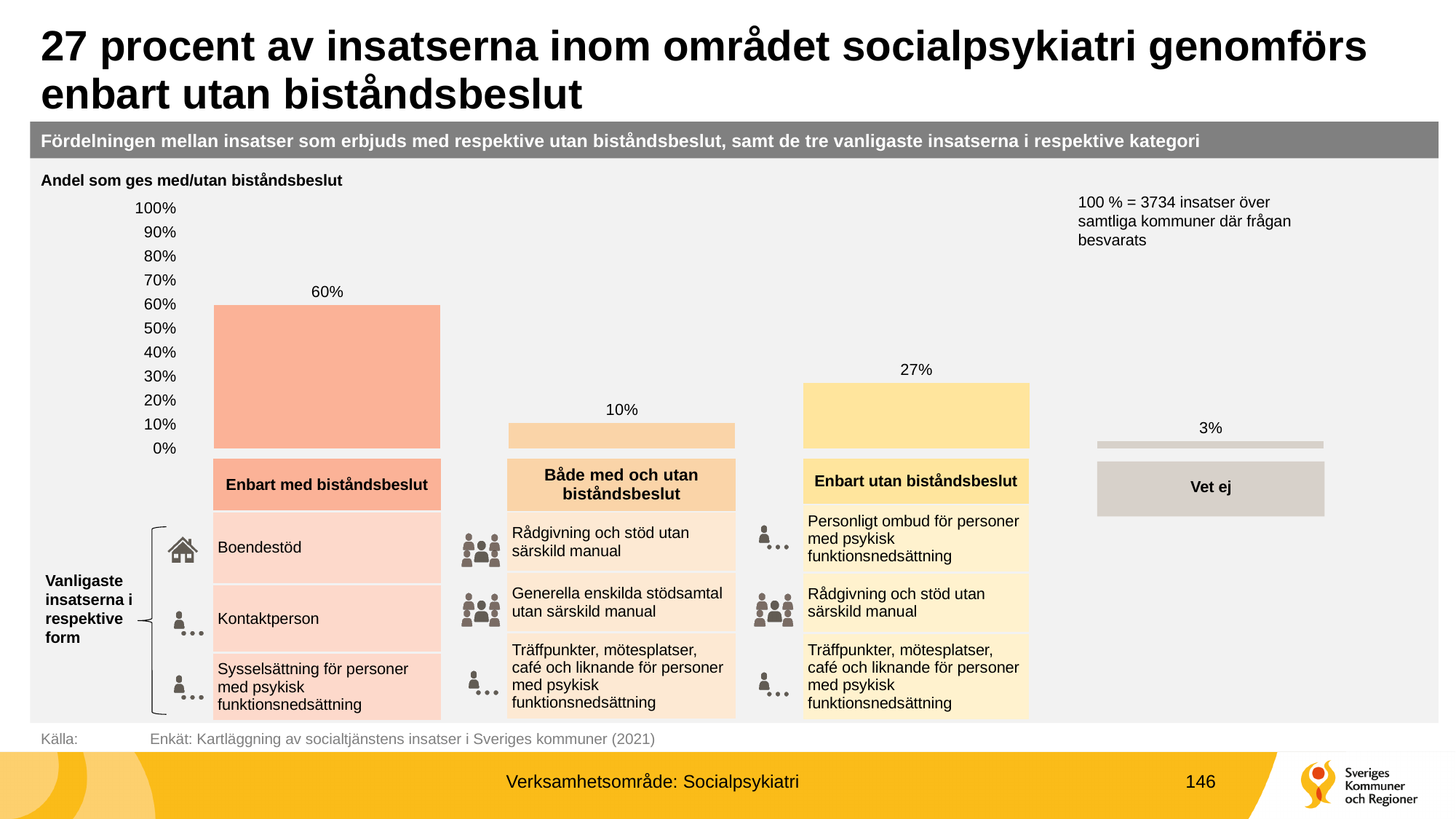
How many categories are shown in the bar chart? 4 Which category has the lowest share? Vet ej What is the title of the chart area above the bars? Andel som ges med/utan biståndsbeslut What is the difference in percentage points between 'Enbart med biståndsbeslut' and 'Enbart utan biståndsbeslut'? 33 percentage points How many insatser does 100% correspond to according to the note on the chart? 3734 Which is larger, the share for 'Både med och utan biståndsbeslut' or the share for 'Enbart utan biståndsbeslut'? Enbart utan biståndsbeslut What percentage of insatser is shown for 'Enbart med biståndsbeslut'? 60% Which category has the highest share? Enbart med biståndsbeslut What percentage of insatser is shown for 'Både med och utan biståndsbeslut'? 10% What percentage of insatser is shown for 'Enbart utan biståndsbeslut'? 27% What kind of chart is used to show the share given with/without biståndsbeslut? Bar chart What percentage of insatser is shown for 'Vet ej'? 3%